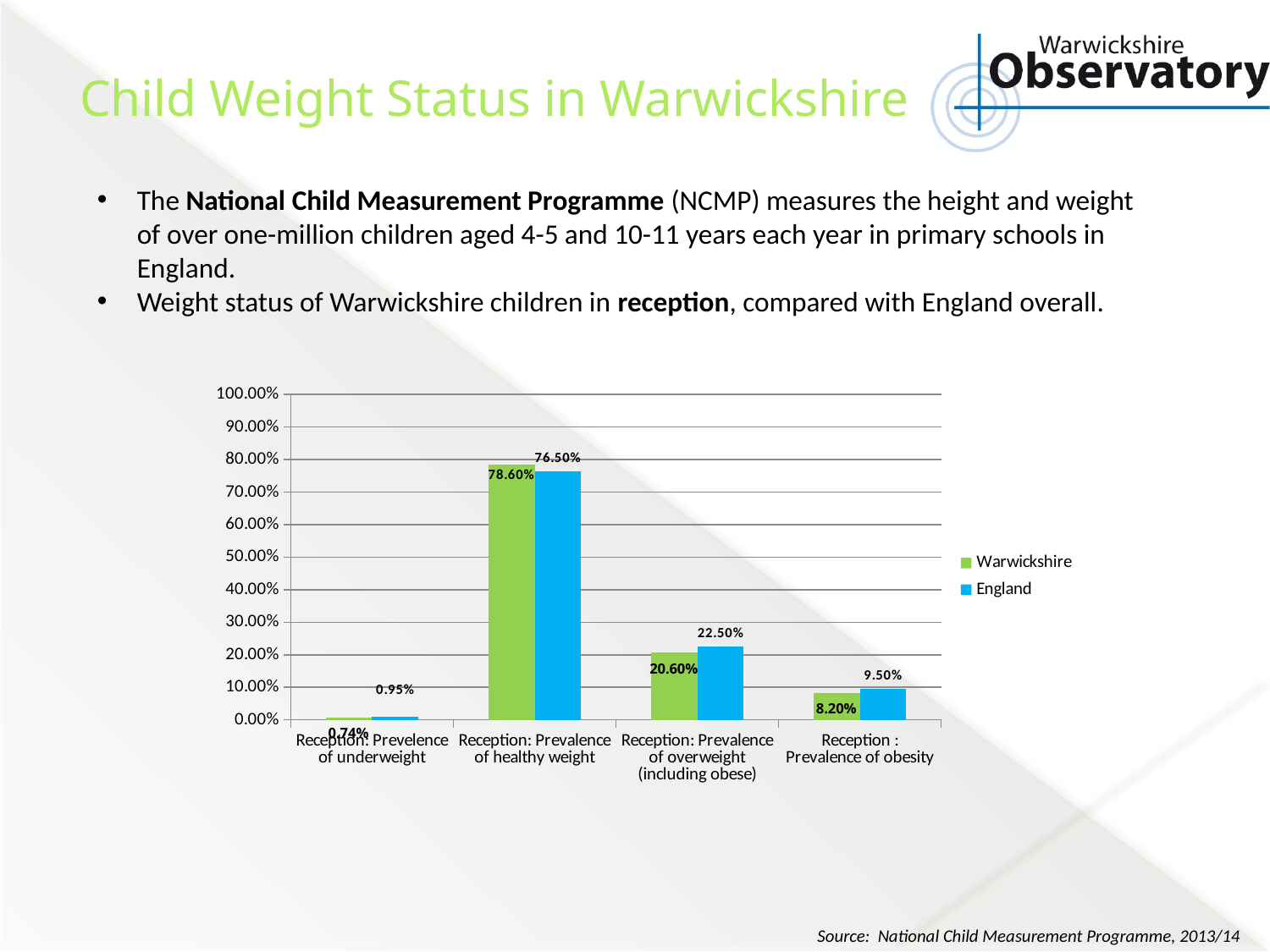
What is the Warwickshire value for Reception: Prevalence of obesity? 8.20% What is the difference between the England and Warwickshire values for Reception: Prevalence of obesity? 1.30% What is the England value for Reception: Prevalence of overweight (including obese)? 22.50% How many series does the chart legend list? 2 For Reception: Prevalence of healthy weight, which is larger, Warwickshire or England? Warwickshire What is the Warwickshire value for Reception: Prevalence of healthy weight? 78.60% How many categories are shown on the x axis of the chart? 4 What is the England value for Reception: Prevelence of underweight? 0.95% Which category has the lowest value for the England series? Reception: Prevelence of underweight What kind of chart is shown on the slide? bar chart Is the Warwickshire value for Reception: Prevalence of overweight (including obese) greater or less than 30.00%? less Which category has the highest value for the Warwickshire series? Reception: Prevalence of healthy weight